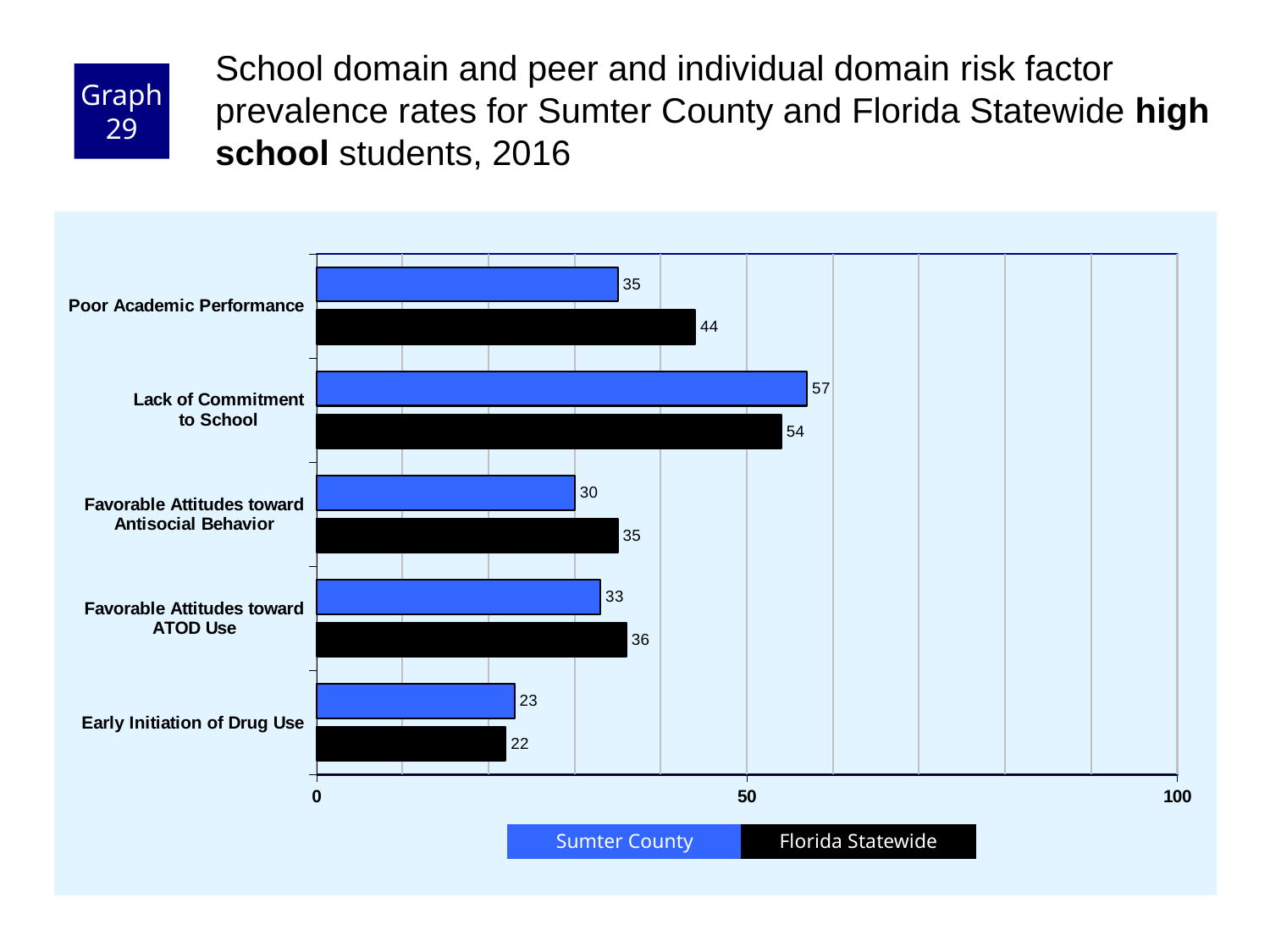
What is the difference between the Florida Statewide and Sumter County values for Poor Academic Performance? 9 Which risk factor has the lowest Florida Statewide value? Early Initiation of Drug Use Which risk factor has the highest Sumter County value? Lack of Commitment to School For Favorable Attitudes toward ATOD Use, which is larger: the Sumter County value or the Florida Statewide value? Florida Statewide What kind of chart is shown on the slide? Bar chart How many risk factor categories are shown on the chart? 5 What is the Florida Statewide value for Lack of Commitment to School? 54 What is the Sumter County value for Early Initiation of Drug Use? 23 Which colour represents Florida Statewide in the chart? Black What is the Sumter County value for Poor Academic Performance? 35 Is the Sumter County value for Lack of Commitment to School greater or less than 50? greater How many series does the legend list? 2